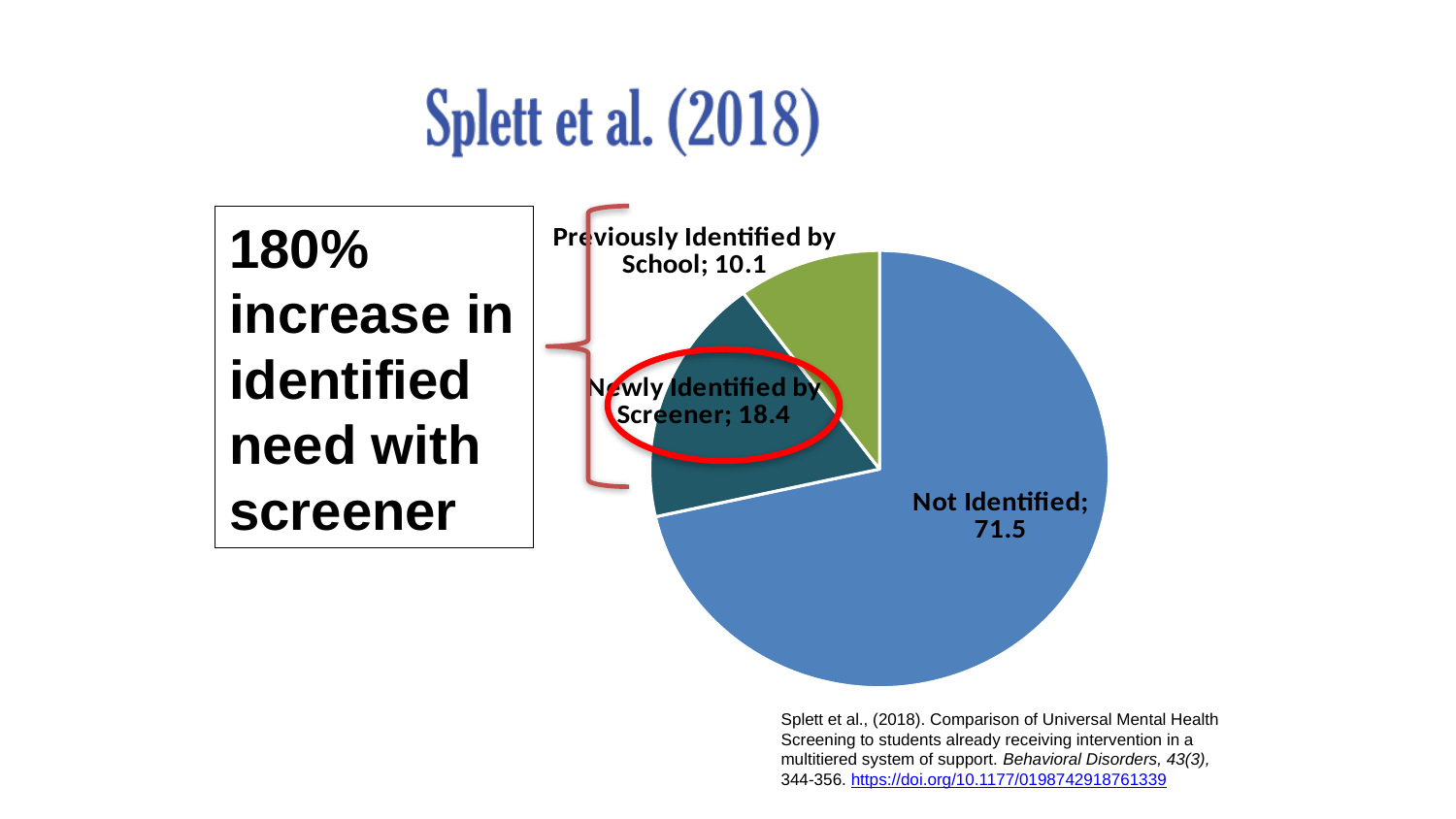
What is the title shown above the pie chart? Splett et al. (2018) Which is larger, Newly Identified by Screener or Previously Identified by School? Newly Identified by Screener What is the difference between the values for Newly Identified by Screener and Previously Identified by School? 8.3 What is the value for Not Identified? 71.5 How many slices does the pie chart have? 3 What is the value for Previously Identified by School? 10.1 What kind of chart is shown on the slide? Pie chart Which category has the smallest slice of the pie? Previously Identified by School Which category has the largest slice of the pie? Not Identified What is the difference between the values for Not Identified and Newly Identified by Screener? 53.1 What is the value for Newly Identified by Screener? 18.4 Which slice of the pie chart is circled in red? Newly Identified by Screener